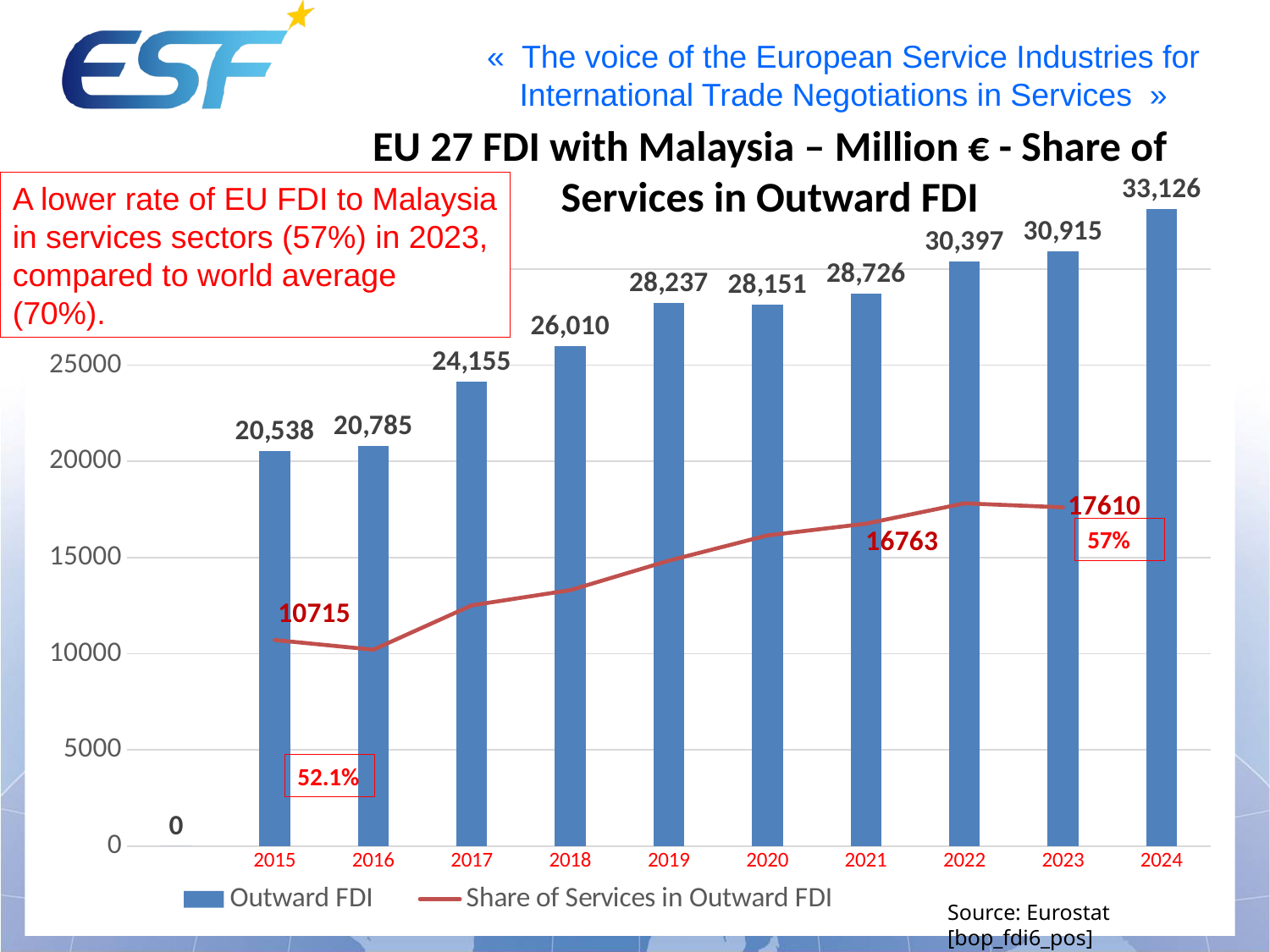
Which year has the lowest Outward FDI? 2015 What is the Outward FDI value for 2024? 33,126 Which year has the larger Outward FDI, 2019 or 2020? 2019 What kind of chart is used to show Outward FDI? bar chart Which year has the highest Outward FDI? 2024 What is the value of the Share of Services in Outward FDI line for 2021? 16763 What is the difference between the Outward FDI in 2024 and in 2015? 12,588 How many years are labelled on the x axis? 10 How many series does the legend list? 2 Is the Outward FDI value for 2017 greater or less than 25000? less What is the difference between the Outward FDI in 2023 and in 2022? 518 What is the Outward FDI value for 2015? 20,538